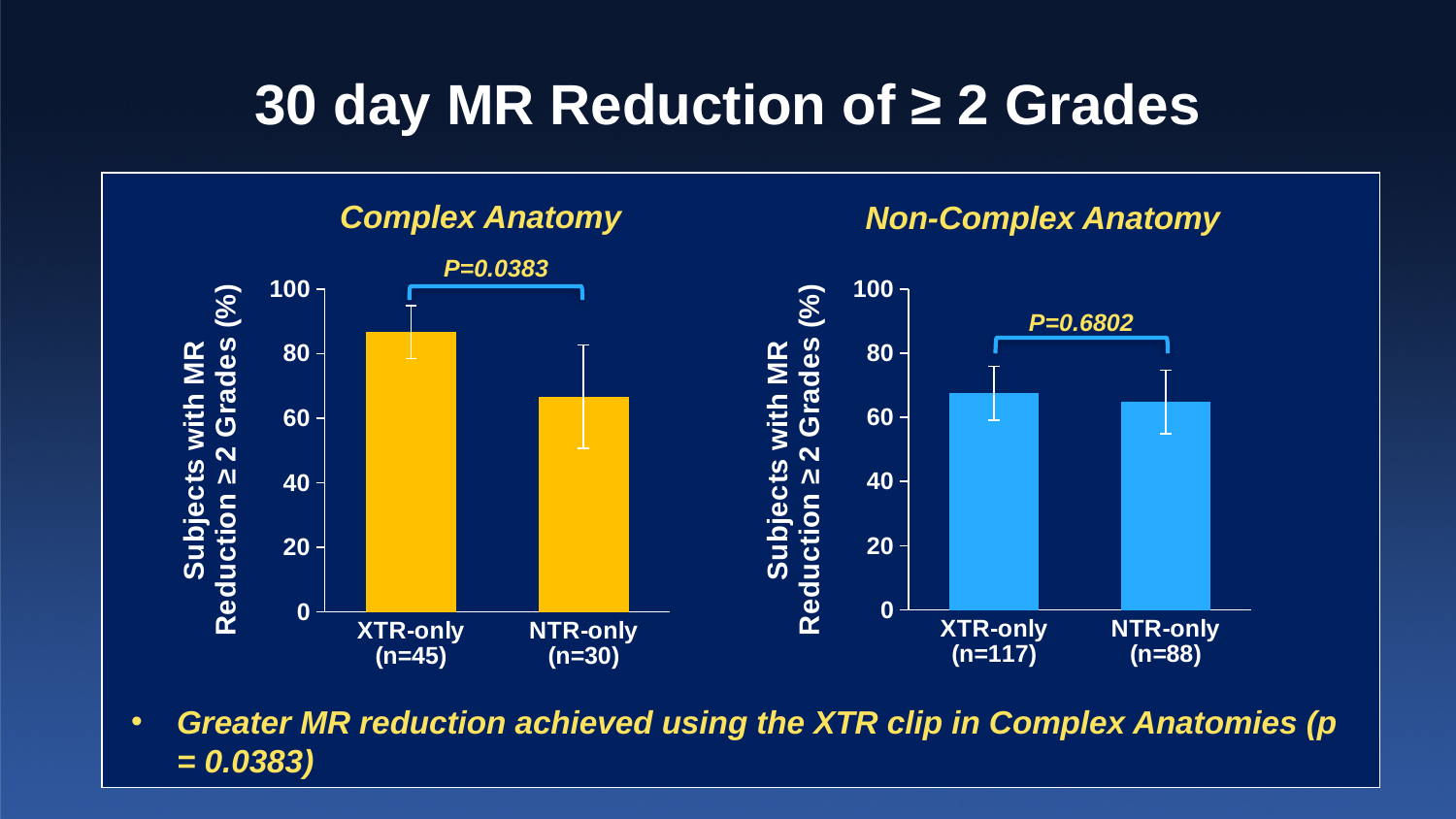
In the Non-Complex Anatomy chart, how many categories are shown on the x axis? 2 In the Complex Anatomy chart, is the value for XTR-only greater or less than 80? greater In the Non-Complex Anatomy chart, is the value for NTR-only greater or less than 80? less In the Complex Anatomy chart, which category has the higher bar? XTR-only (n=45) What is the sample size (n) for the XTR-only group in the Non-Complex Anatomy chart? n=117 In the Complex Anatomy chart, how many bars are plotted? 2 In the Complex Anatomy chart, is the value for NTR-only greater or less than 80? less In the Complex Anatomy chart, what kind of chart is used? bar chart In the Complex Anatomy chart, which category has the lower bar? NTR-only (n=30) In the Complex Anatomy chart, is the bar for XTR-only larger or smaller than the bar for NTR-only? larger What P value is shown above the bars in the Non-Complex Anatomy chart? P=0.6802